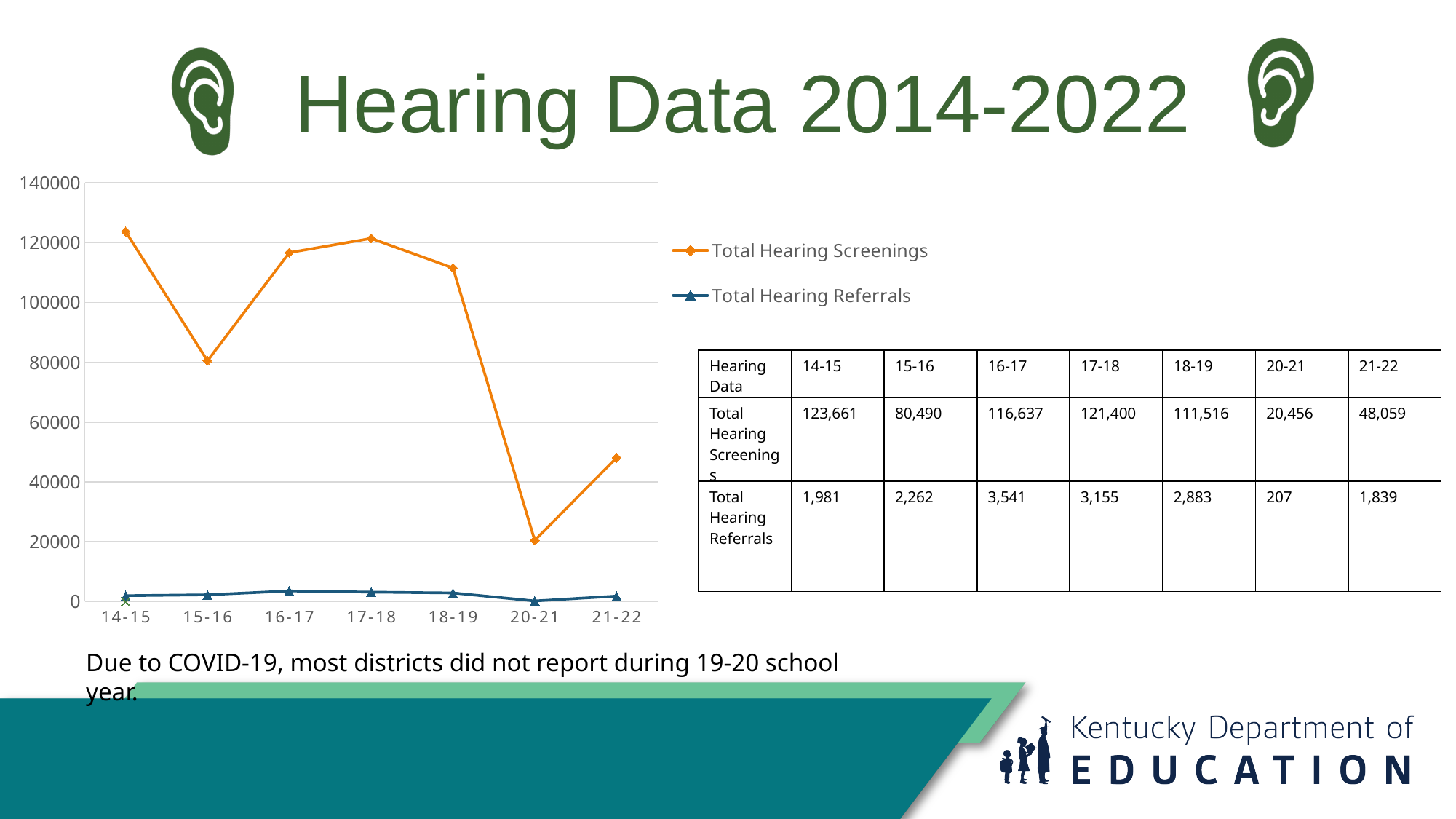
Do Total Hearing Screenings rise or fall from 18-19 to 20-21? fall Which school year has the lowest Total Hearing Screenings? 20-21 How many school years are plotted along the x axis of the chart? 7 Which is larger, Total Hearing Screenings in 16-17 or in 18-19? 16-17 What is the value of Total Hearing Screenings for 14-15? 123,661 What is the difference between Total Hearing Screenings in 17-18 and 15-16? 40,910 How many series does the chart legend list? 2 Is the value for Total Hearing Screenings in 21-22 greater or less than 60000? less What kind of chart is shown on the slide? line chart Which school year has the highest Total Hearing Referrals? 16-17 Which series is drawn in orange on the chart? Total Hearing Screenings What is the value of Total Hearing Referrals for 16-17? 3,541